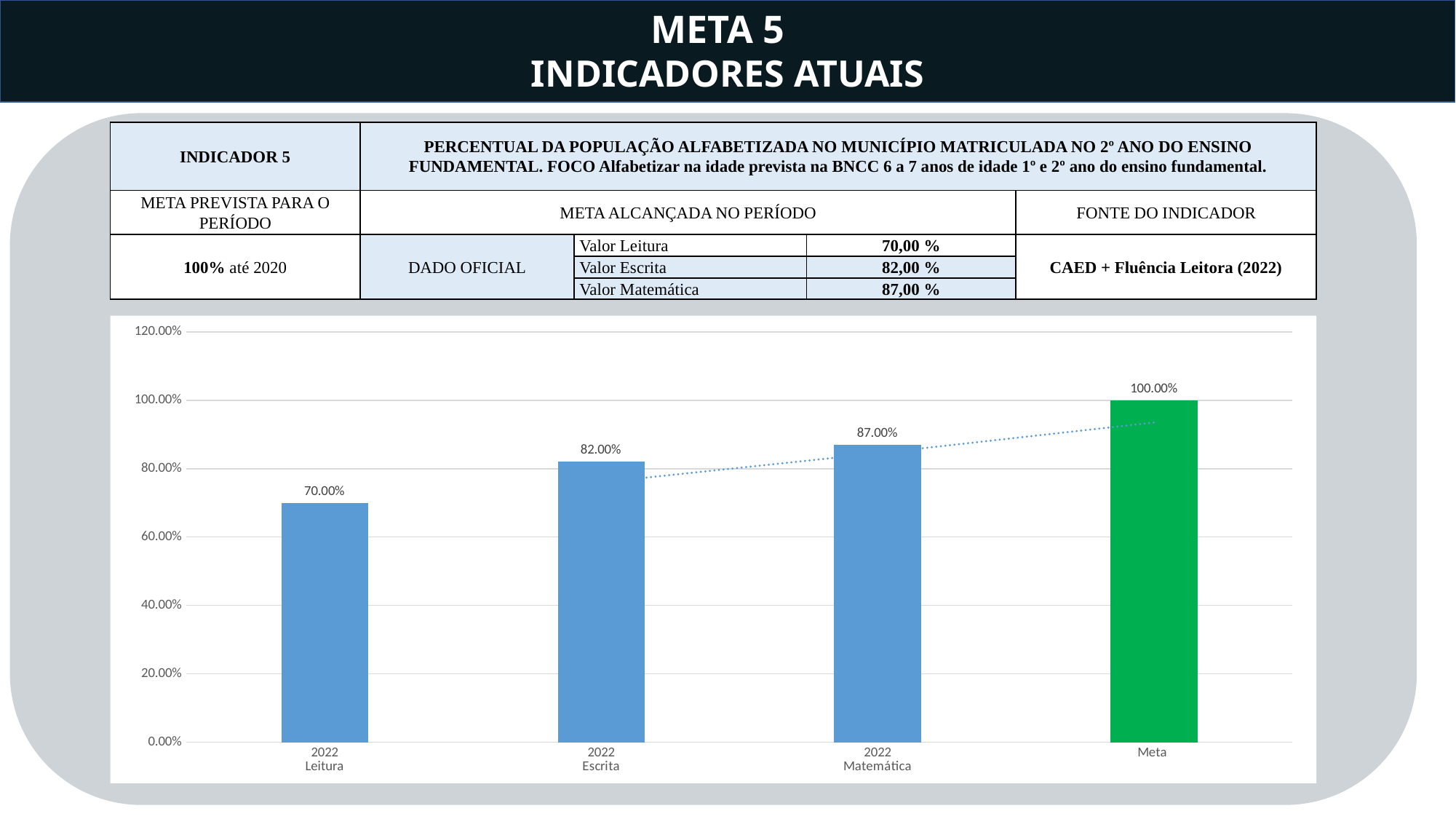
What is the value shown for 2022 Matemática? 87.00% What colour is the Meta bar? Green How many bars are plotted in the chart? 4 What is the difference between the 2022 Escrita and 2022 Leitura values? 12.00% What is the value shown for 2022 Leitura? 70.00% What is the difference between the Meta value and the 2022 Matemática value? 13.00% Which is larger, the value for 2022 Escrita or 2022 Matemática? 2022 Matemática What is the value shown for the Meta bar? 100.00% What is the value shown for 2022 Escrita? 82.00% Which category has the highest value in the chart? Meta What kind of chart is shown on the slide? Bar chart Which category has the lowest value in the chart? 2022 Leitura